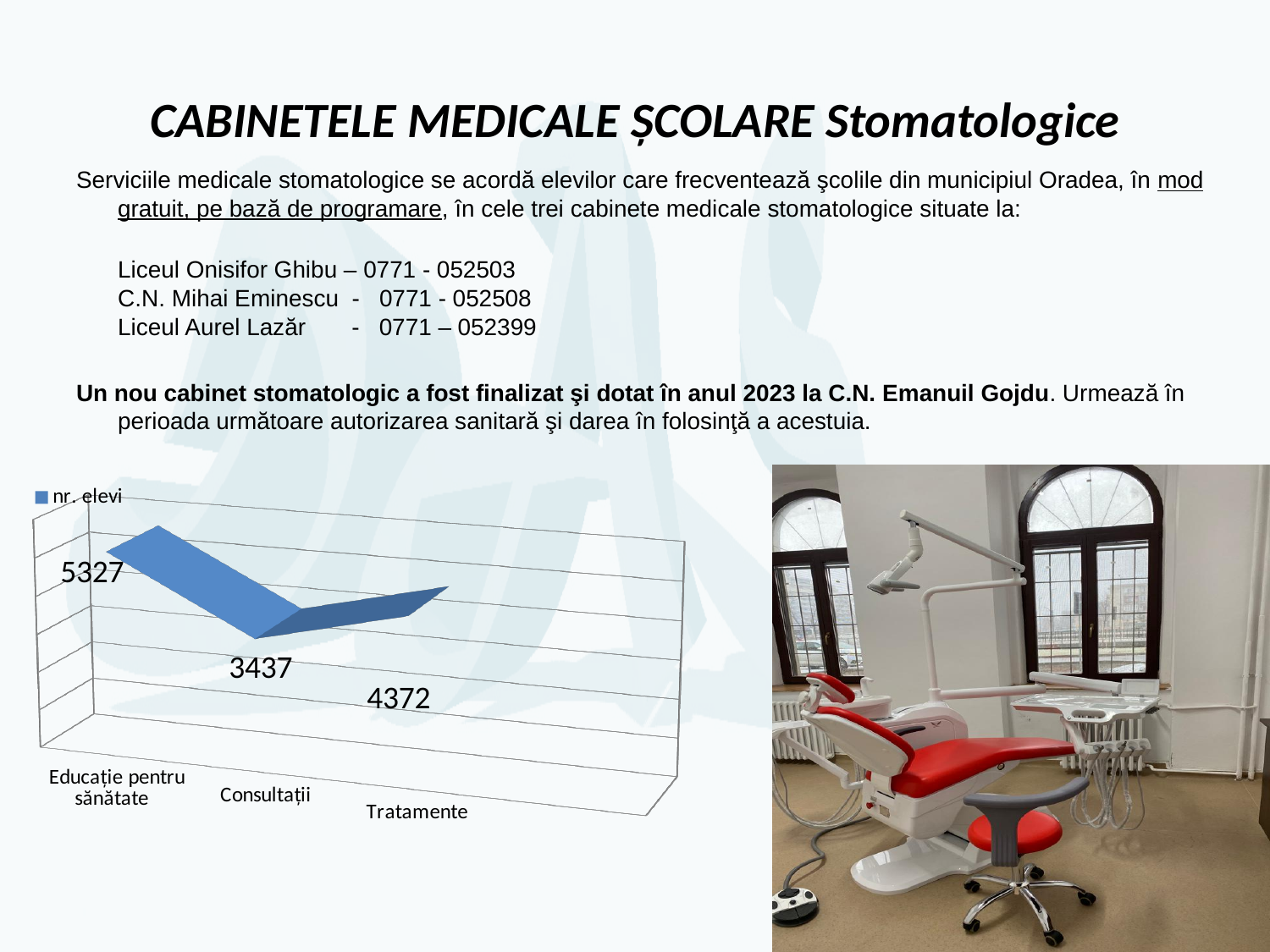
How many series does the legend list? 1 Which is larger, the value for Tratamente or the value for Consultații? Tratamente What is the value for Tratamente? 4372 What is the value for Educație pentru sănătate? 5327 Which category has the lowest value? Consultații What is the difference between the values for Tratamente and Consultații? 935 What is the name of the series in the chart legend? nr. elevi What kind of chart is shown on the slide? 3D line chart How many categories are shown on the chart? 3 What is the value for Consultații? 3437 Which category has the highest value? Educație pentru sănătate What is the difference between the values for Educație pentru sănătate and Consultații? 1890